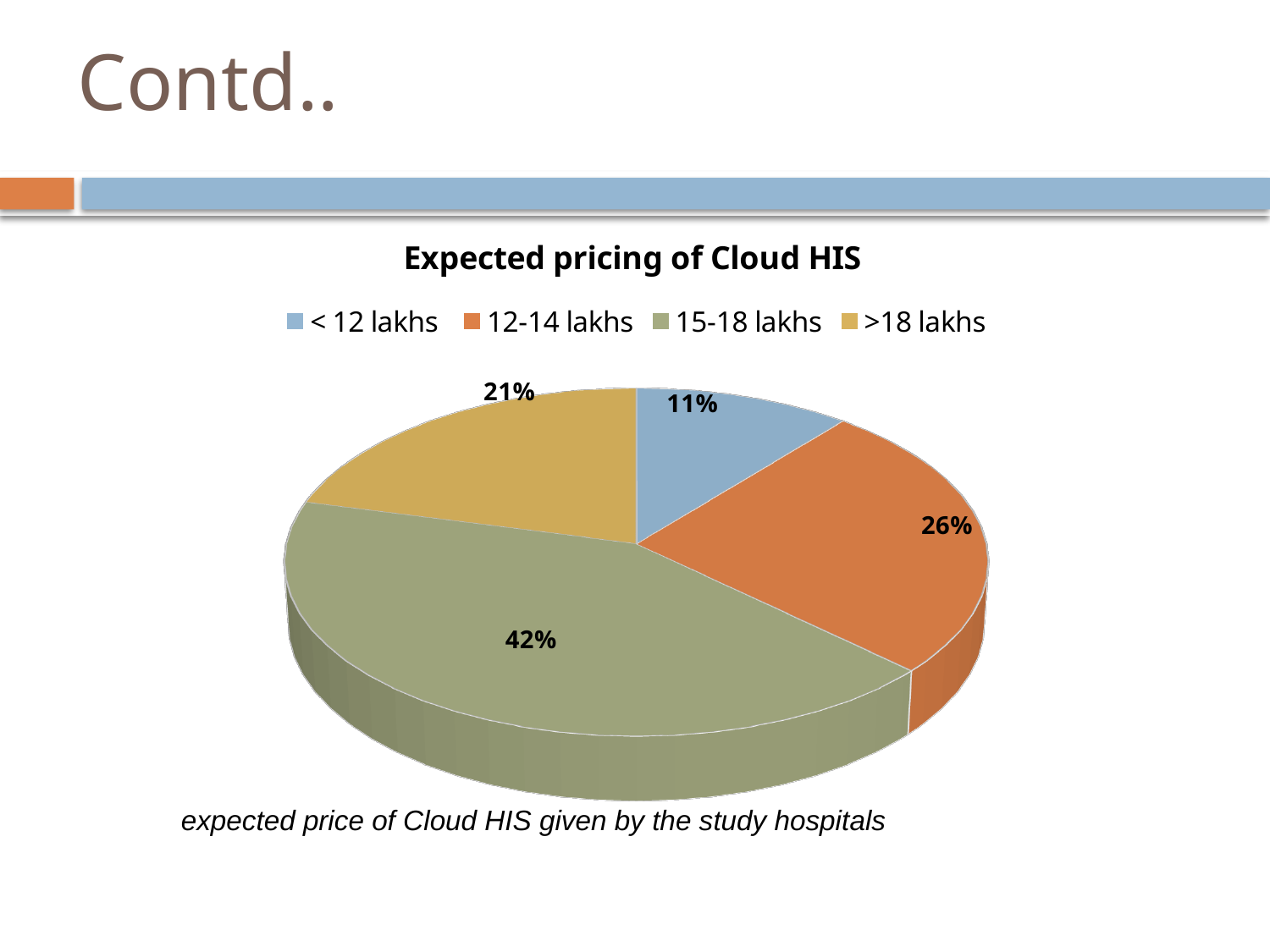
Which is larger, the 12-14 lakhs slice or the >18 lakhs slice? 12-14 lakhs What share of the pie does the 15-18 lakhs slice represent? 42% Which colour represents the 12-14 lakhs category in the legend? Orange What is the value shown for the 12-14 lakhs category? 26% What share of the pie does the < 12 lakhs slice represent? 11% What is the title of the chart? Expected pricing of Cloud HIS Which category has the smallest slice of the pie? < 12 lakhs What kind of chart is shown on the slide? Pie chart How many categories does the pie chart show? 4 What is the difference between the 15-18 lakhs share and the 12-14 lakhs share? 16% What is the value shown for the >18 lakhs category? 21% Which category has the largest slice of the pie? 15-18 lakhs